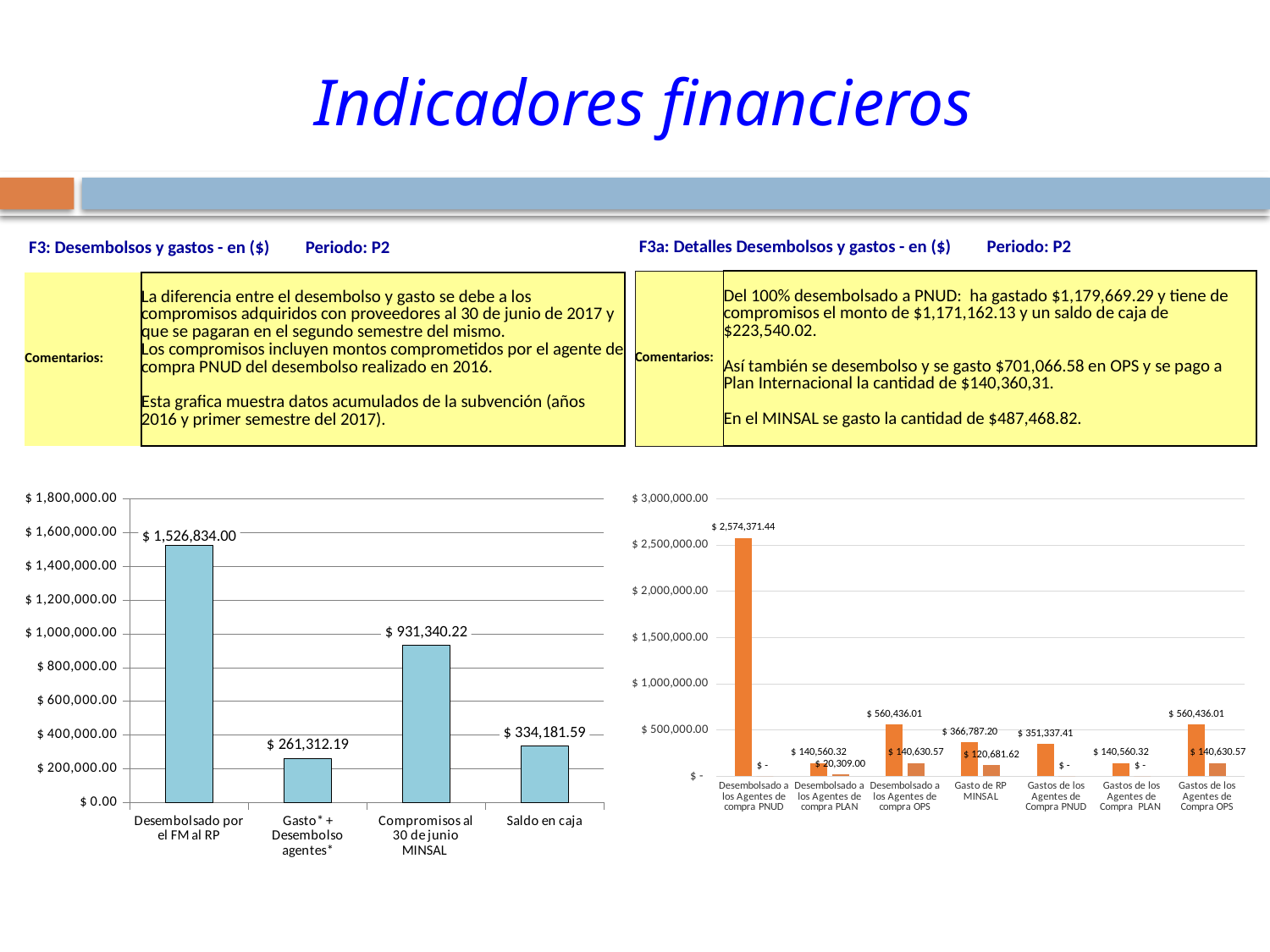
What type of chart is the left chart (F3: Desembolsos y gastos)? Bar chart In the left chart (F3: Desembolsos y gastos), which category has the lowest value? Gasto* + Desembolso agentes* In the right chart (F3a: Detalles Desembolsos y gastos), which category has the highest orange bar? Desembolsado a los Agentes de compra PNUD In the left chart (F3: Desembolsos y gastos), what is the value for 'Saldo en caja'? $ 334,181.59 In the left chart (F3: Desembolsos y gastos), what is the difference between 'Compromisos al 30 de junio MINSAL' and 'Saldo en caja'? $ 597,158.63 In the left chart (F3: Desembolsos y gastos), which category has the highest value? Desembolsado por el FM al RP In the right chart (F3a: Detalles Desembolsos y gastos), what is the value of the orange bar for 'Desembolsado a los Agentes de compra PNUD'? $ 2,574,371.44 In the right chart (F3a: Detalles Desembolsos y gastos), is the orange bar for 'Desembolsado a los Agentes de compra OPS' larger or smaller than the orange bar for 'Gastos de los Agentes de Compra PNUD'? Larger In the left chart (F3: Desembolsos y gastos), what is the value for 'Desembolsado por el FM al RP'? $ 1,526,834.00 In the right chart (F3a: Detalles Desembolsos y gastos), how many categories are shown on the x axis? 7 In the left chart (F3: Desembolsos y gastos), how many categories are shown? 4